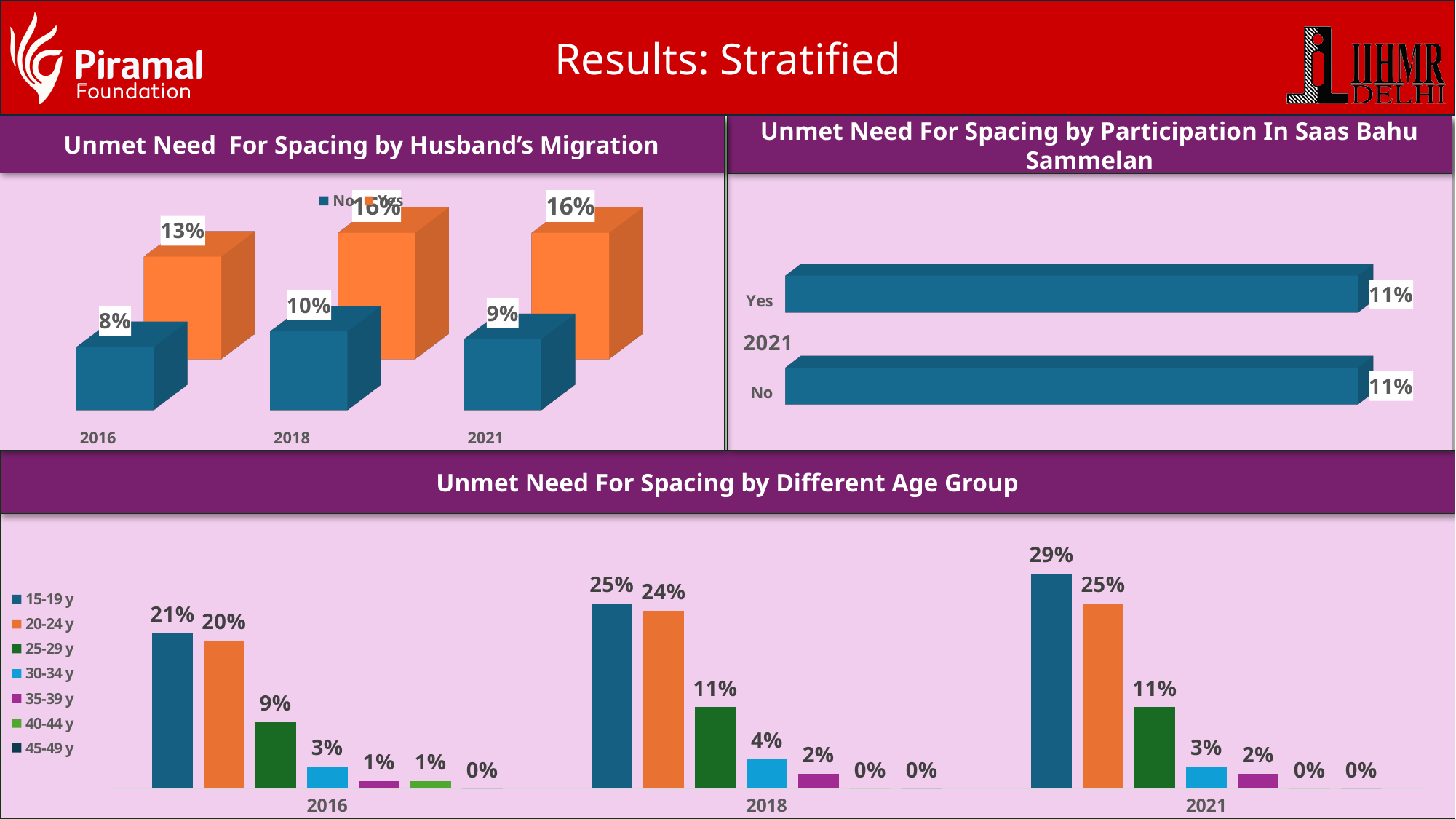
In the 'Unmet Need For Spacing by Different Age Group' chart, how many series does the legend list? 7 In the 'Unmet Need For Spacing by Different Age Group' chart, does the 15-19 y value rise or fall from 2016 to 2021? Rise In the 'Unmet Need For Spacing by Different Age Group' chart, which age group has the highest value in 2018? 15-19 y In the 'Unmet Need For Spacing by Different Age Group' chart, which is larger in 2016: the 25-29 y value or the 30-34 y value? 25-29 y In the 'Unmet Need For Spacing by Participation In Saas Bahu Sammelan' chart, what kind of chart is used? Bar chart In the 'Unmet Need For Spacing by Husband's Migration' chart, what is the value for the 'Yes' series in 2018? 16% In the 'Unmet Need For Spacing by Husband's Migration' chart, what is the value for the 'No' series in 2016? 8% In the 'Unmet Need For Spacing by Husband's Migration' chart, what is the difference between the 'Yes' and 'No' values in 2021? 7% In the 'Unmet Need For Spacing by Different Age Group' chart, what is the value for the 15-19 y group in 2021? 29% In the 'Unmet Need For Spacing by Different Age Group' chart, what is the difference between the 15-19 y value in 2021 and in 2016? 8% In the 'Unmet Need For Spacing by Husband's Migration' chart, how many years are shown on the x axis? 3 In the 'Unmet Need For Spacing by Participation In Saas Bahu Sammelan' chart, what is the value for 'Yes'? 11%